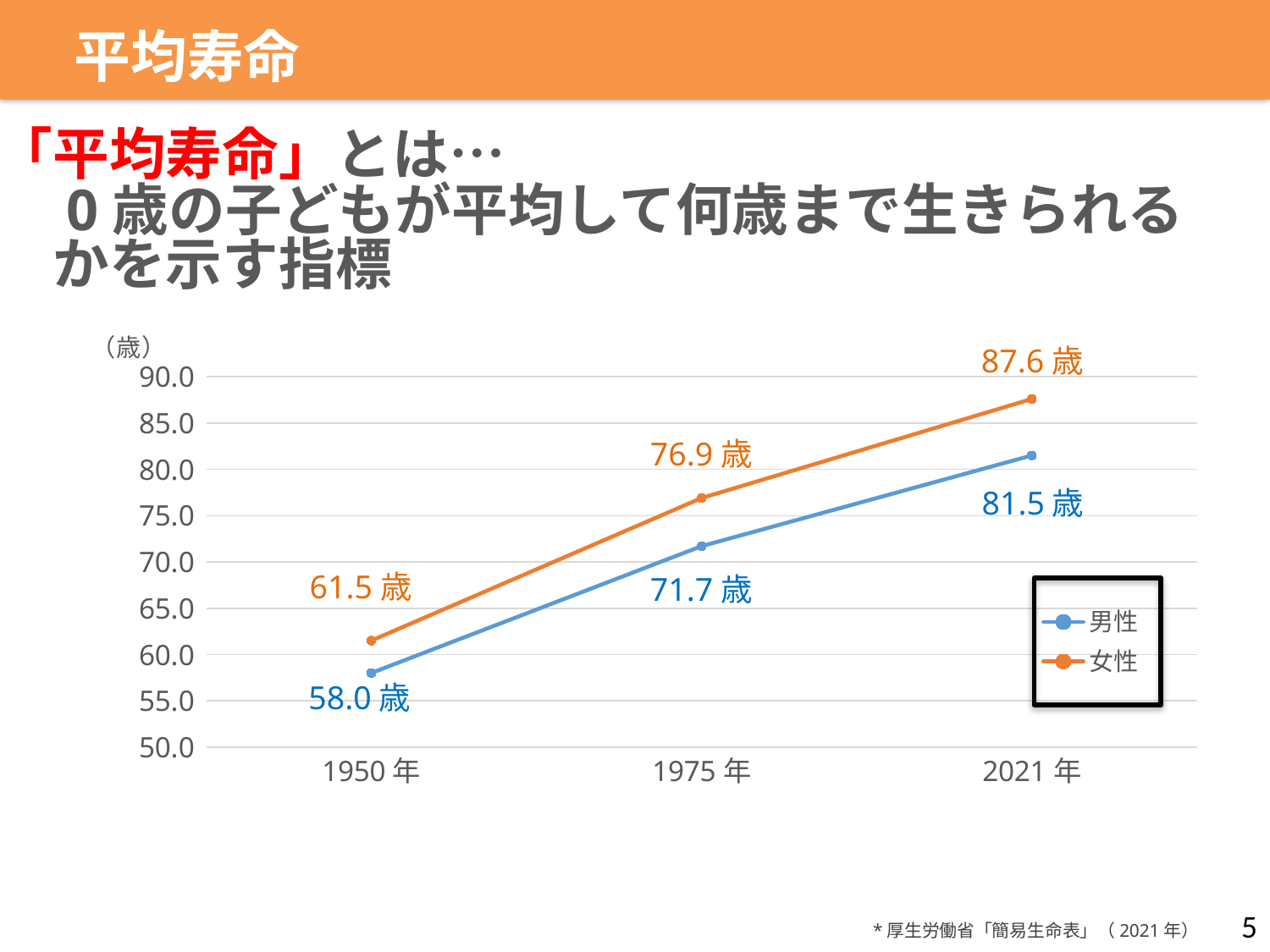
What is the value for 女性 in 2021年? 87.6歳 What kind of chart is shown? line chart What is the value for 男性 in 1975年? 71.7歳 What is the difference between 女性 and 男性 in 2021年? 6.1歳 In which year is the value for 男性 highest? 2021年 Which is larger in 1975年, 男性 or 女性? 女性 How many series does the legend list? 2 Do the values for 男性 rise or fall from 1950年 to 2021年? rise What is the value for 男性 in 1950年? 58.0歳 In which year is the value for 女性 lowest? 1950年 What is the value for 女性 in 1950年? 61.5歳 How many years are shown on the x axis? 3